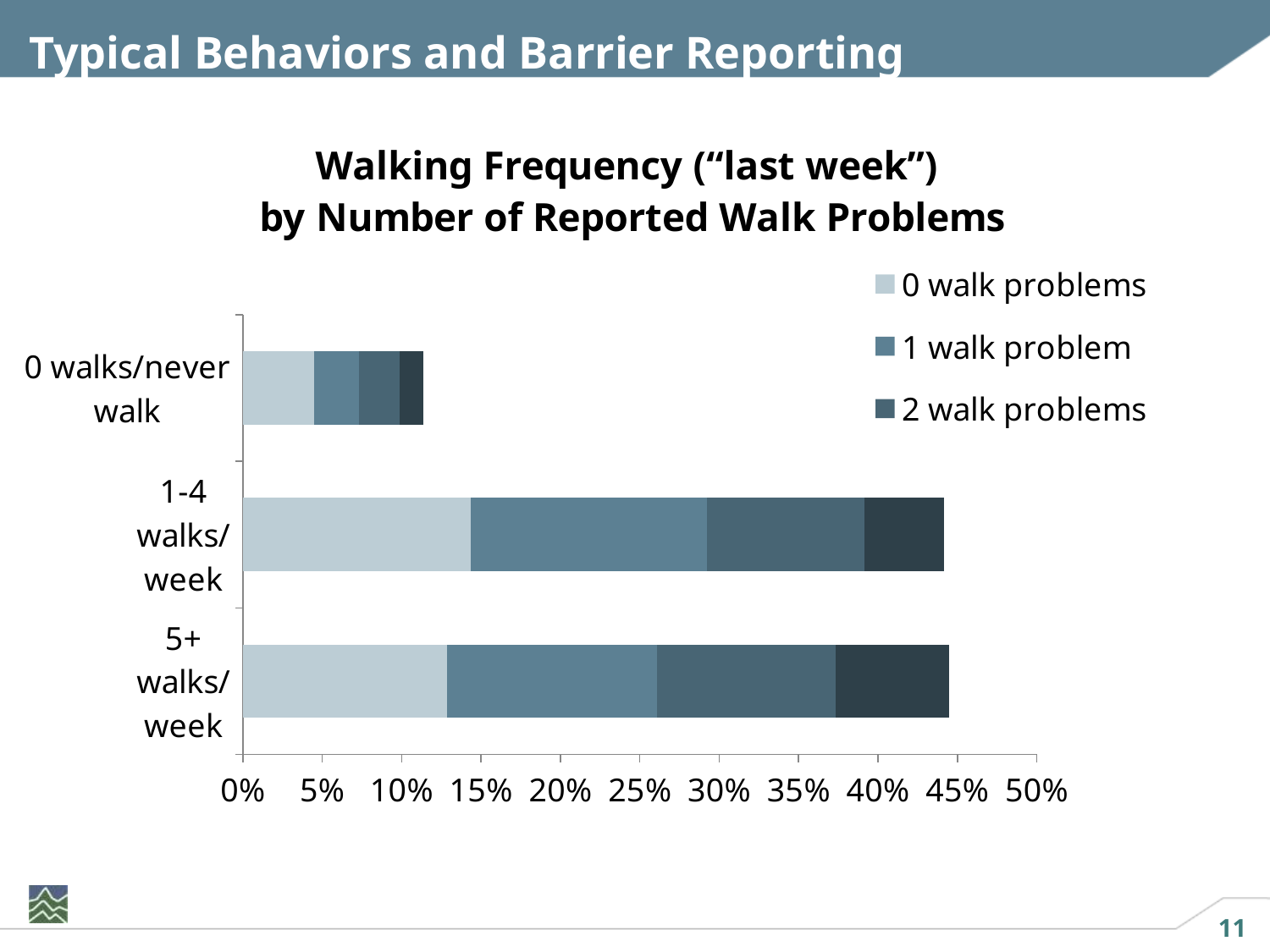
How many series does the chart's legend list? 3 How many walking-frequency categories are plotted on the chart? 3 Which has the larger total bar: 1-4 walks/week or 0 walks/never walk? 1-4 walks/week Is the total bar for 0 walks/never walk greater or less than 15%? less Which walking-frequency category has the shortest total bar? 0 walks/never walk Is the total bar for 1-4 walks/week greater or less than 40%? greater Is the total bar for 5+ walks/week greater or less than 40%? greater What is the title of the chart? Walking Frequency ("last week") by Number of Reported Walk Problems What kind of chart is shown on the slide? Stacked bar chart What is the highest value shown on the chart's x axis? 50%